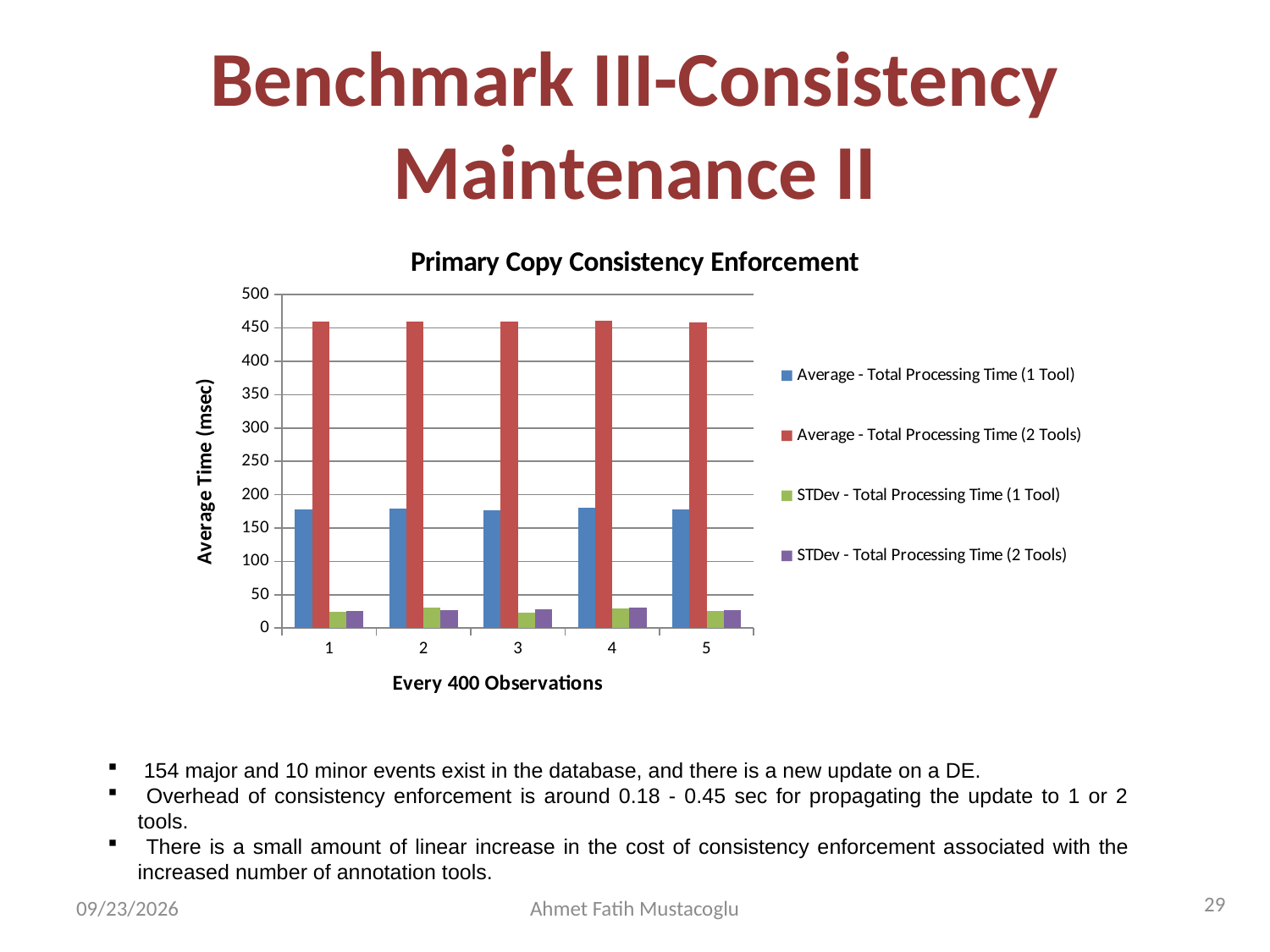
What is the title of the chart? Primary Copy Consistency Enforcement At category 1, which is larger: Average - Total Processing Time (1 Tool) or Average - Total Processing Time (2 Tools)? Average - Total Processing Time (2 Tools) At category 3, which is larger: Average - Total Processing Time (1 Tool) or STDev - Total Processing Time (1 Tool)? Average - Total Processing Time (1 Tool) Is the value for Average - Total Processing Time (2 Tools) at category 3 greater or less than 400? greater What is the label of the y axis? Average Time (msec) What kind of chart is shown on the slide? bar chart How many categories are shown along the x axis? 5 Is the value for STDev - Total Processing Time (1 Tool) at category 2 greater or less than 50? less How many series does the legend list? 4 Is the value for Average - Total Processing Time (2 Tools) at category 5 greater or less than 500? less